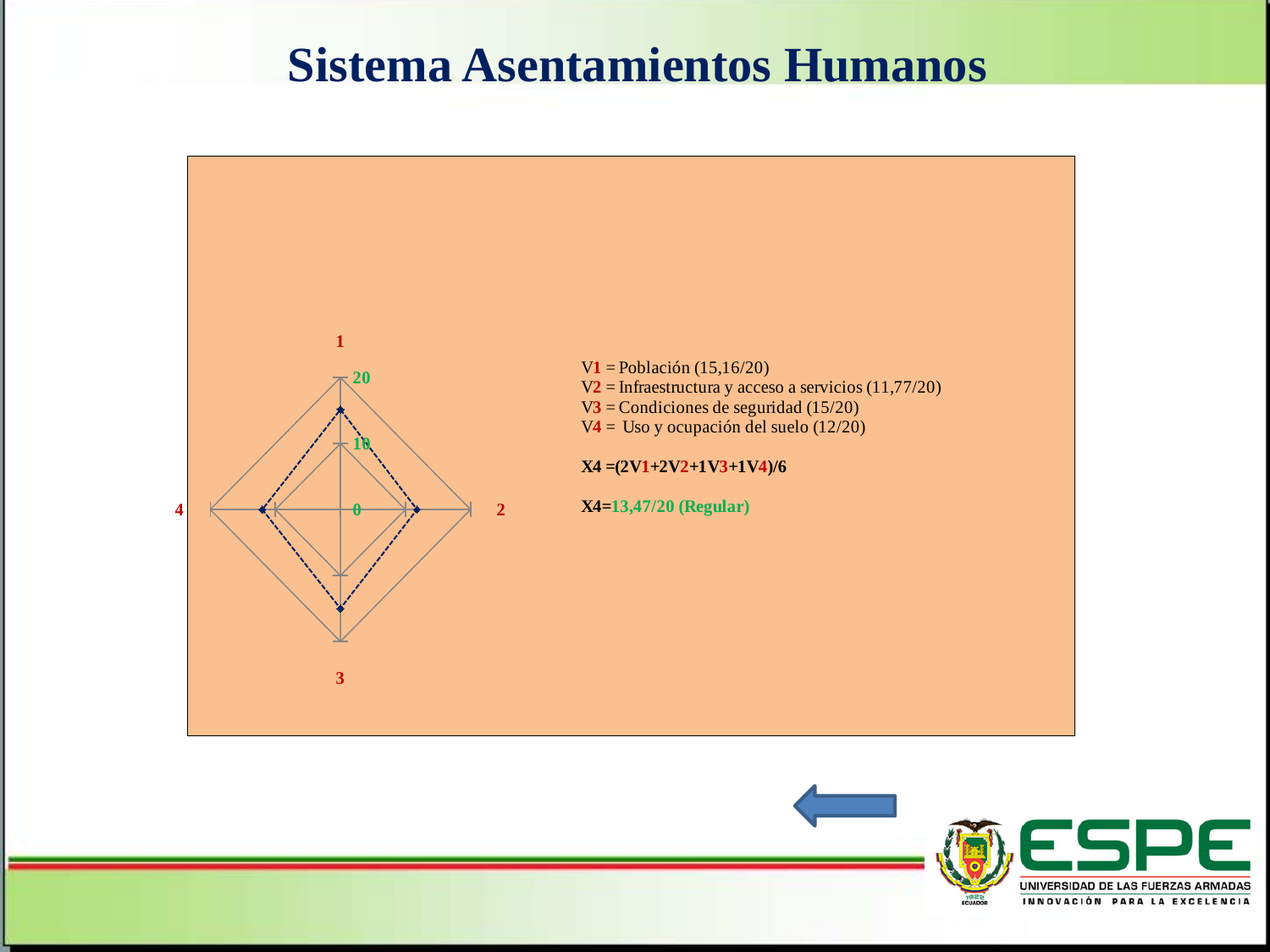
Which has the larger plotted value on the radar chart, axis 3 or axis 4? axis 3 How many axes (categories) does the radar chart have? 4 Is the plotted value on axis 3 of the radar chart greater or less than 20? less Is the plotted value on axis 2 of the radar chart greater or less than 20? less Which has the larger plotted value on the radar chart, axis 1 or axis 2? axis 1 What is the highest tick value shown on the radar chart's axis scale? 20 Is the plotted value on axis 1 of the radar chart greater or less than 10? greater According to the text next to the chart, what is the value given for V1 (Población)? 15,16/20 According to the text next to the chart, what is the value given for V4 (Uso y ocupación del suelo)? 12/20 According to the text next to the chart, what is the value given for V2 (Infraestructura y acceso a servicios)? 11,77/20 What is the final X4 result stated next to the chart? 13,47/20 (Regular) What kind of chart is shown on the slide? radar chart